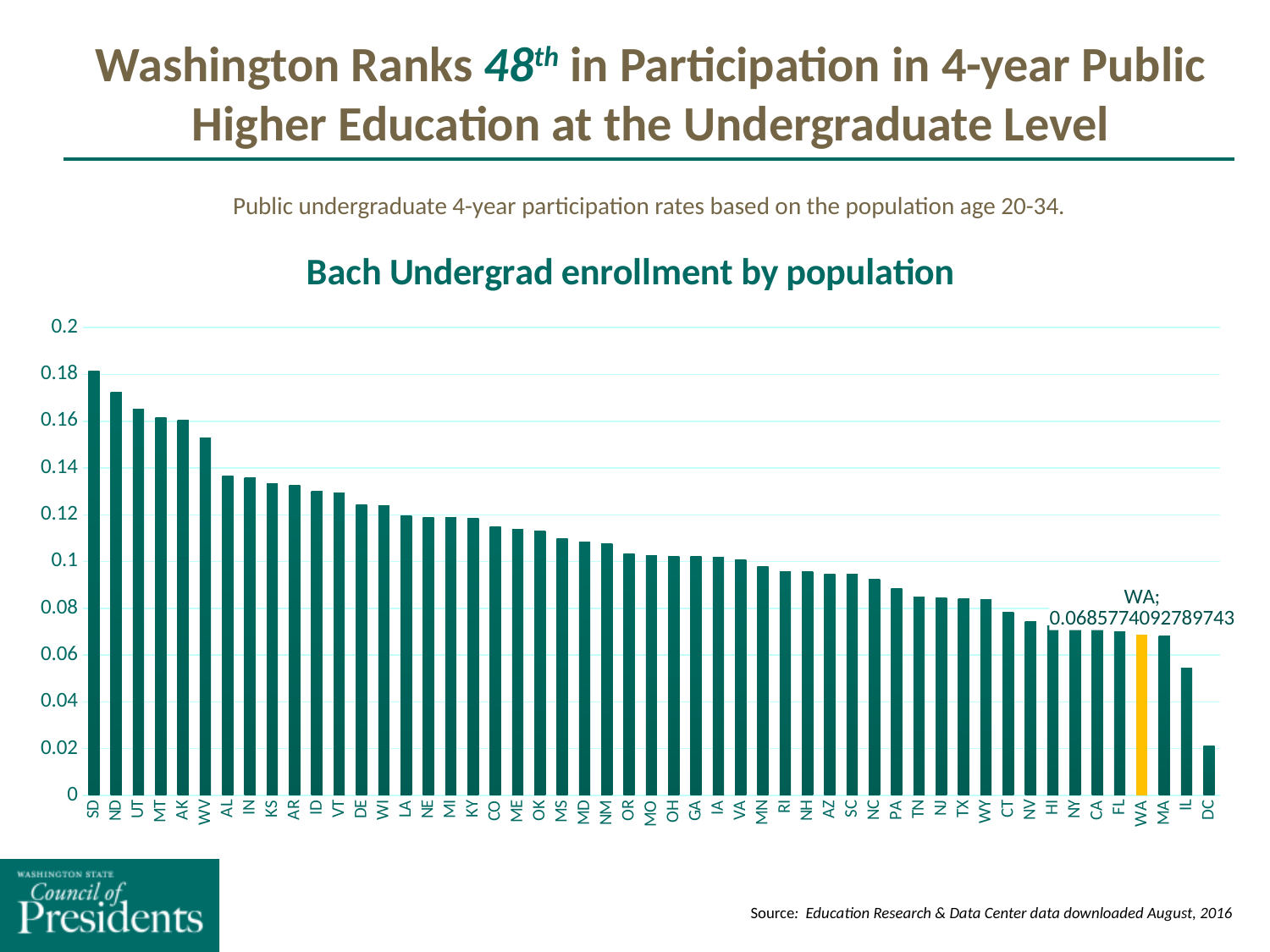
How many bars are plotted in the chart? 51 Which has a larger value, SD or ND? SD Is the value for SD greater or less than 0.16? greater What is the title of the chart? Bach Undergrad enrollment by population Do the values rise or fall moving from left to right along the x axis? fall Which category has the lowest value in the chart? DC Which bar is highlighted in a different colour (yellow) from the rest? WA What type of chart is shown on the slide? bar chart Is the value for DC greater or less than 0.04? less Which state has the highest value in the chart? SD What is the value shown for WA in the chart? 0.0685774092789743 Is the value for IL greater or less than 0.06? less